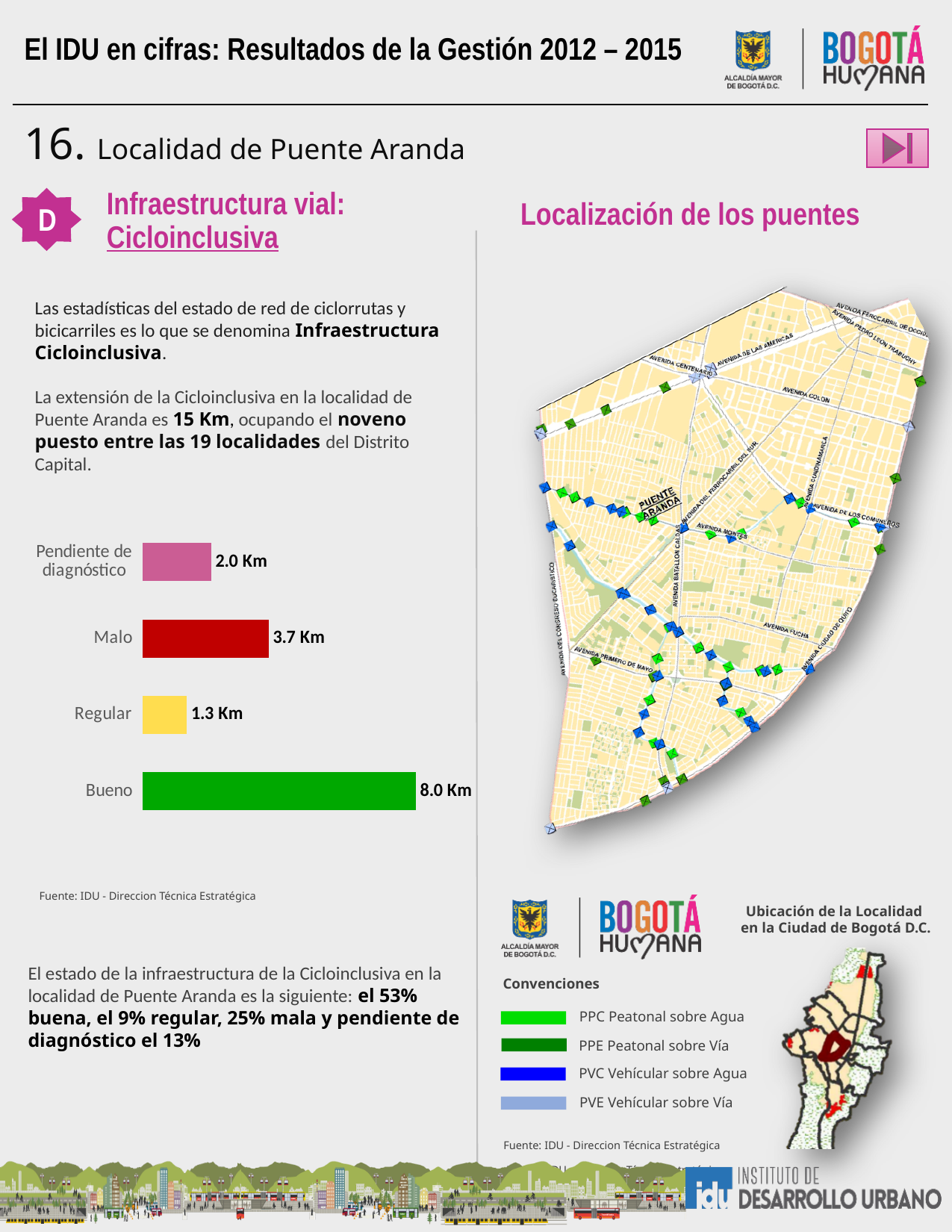
What is the value for Pendiente de diagnóstico in the bar chart? 2.0 Km What is the value for Regular in the bar chart? 1.3 Km Which is larger, the value for Pendiente de diagnóstico or the value for Regular? Pendiente de diagnóstico How many categories are shown in the bar chart? 4 What is the difference between the values for Bueno and Malo? 4.3 Km What is the value for Malo in the bar chart? 3.7 Km What colour is the bar for Malo in the chart? Red What kind of chart is used to show the Cicloinclusiva state data? Bar chart What is the value for Bueno in the bar chart? 8.0 Km What is the difference between the values for Malo and Pendiente de diagnóstico? 1.7 Km Which category has the highest value in the bar chart? Bueno Which category has the lowest value in the bar chart? Regular